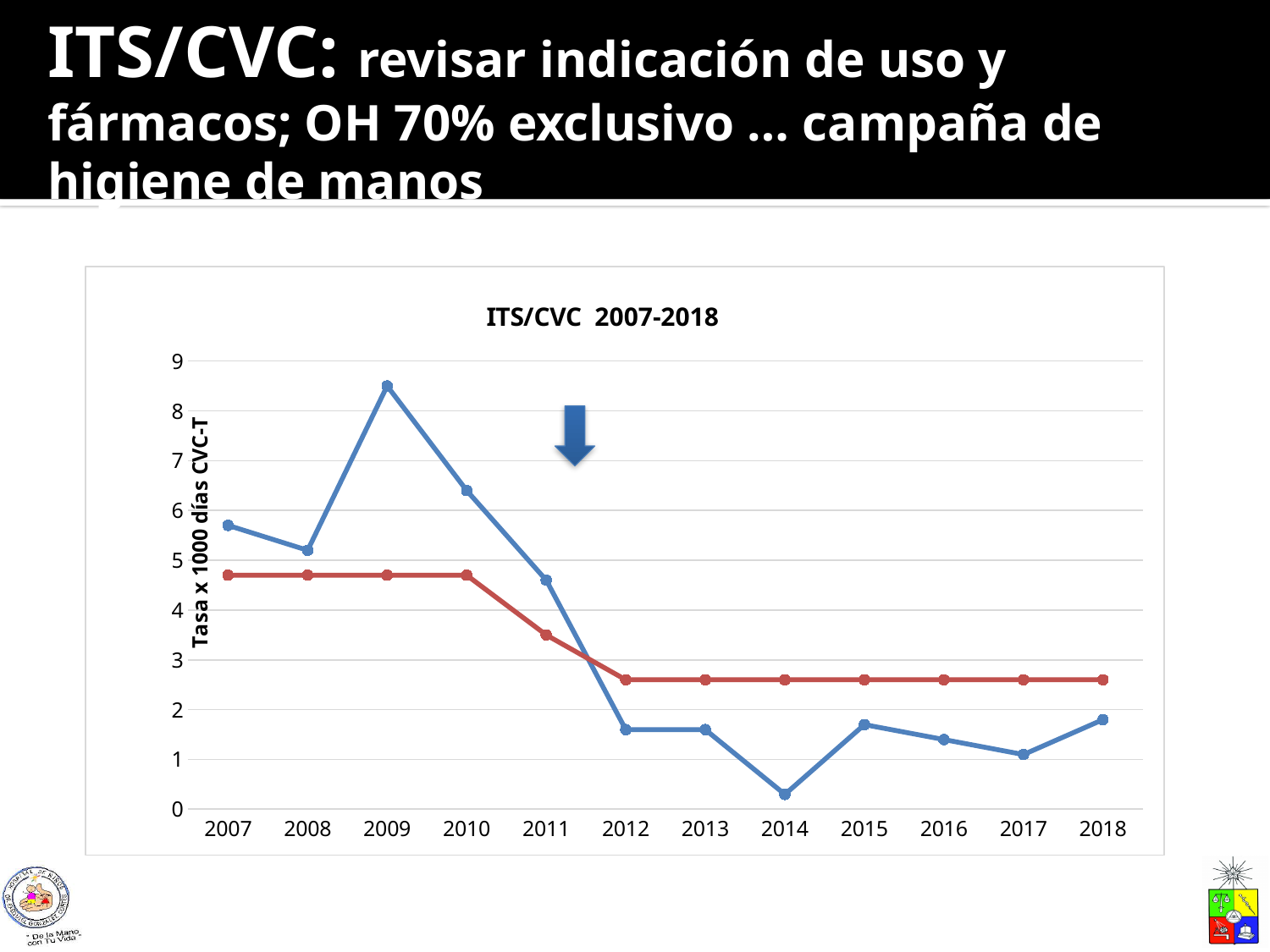
Is the value of the red line in 2007 greater or less than 4? greater What is the label on the vertical axis of the chart? Tasa x 1000 días CVC-T What kind of chart is shown on the slide? line chart Is the value of the blue line in 2014 greater or less than 1? less How many years are shown along the x axis of the chart? 12 What is the title of the chart? ITS/CVC 2007-2018 How many lines are plotted on the chart? 2 Is the value of the red line in 2012 greater or less than 3? less In which year does the blue line reach its lowest value? 2014 In 2013, which line has the higher value, the blue line or the red line? the red line In which year does the blue line reach its highest value? 2009